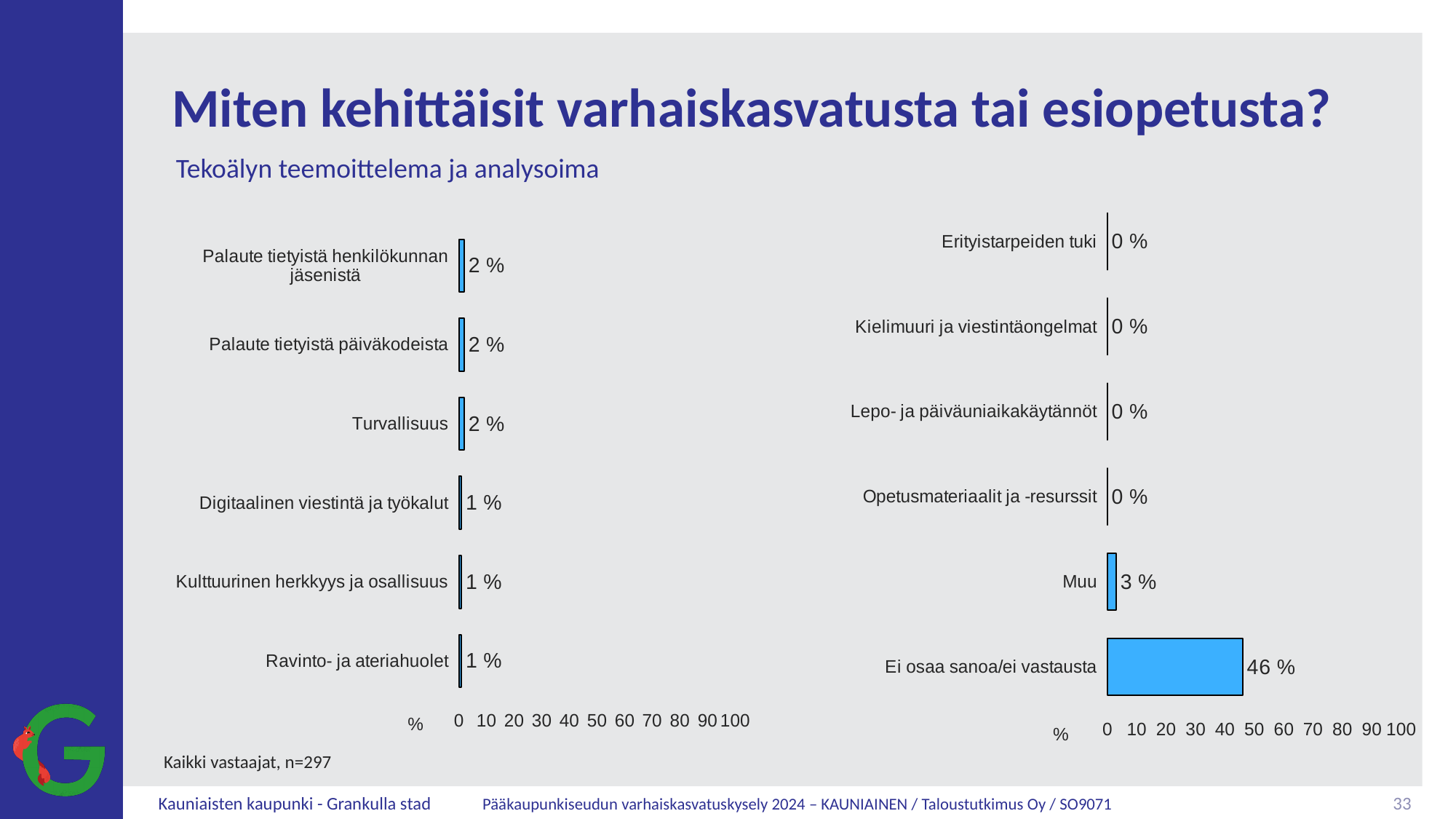
In the right chart, what is the difference between Ei osaa sanoa/ei vastausta and Muu? 43 % In the right chart, what is the value for Kielimuuri ja viestintäongelmat? 0 % In the left chart, what is the difference between Palaute tietyistä päiväkodeista and Digitaalinen viestintä ja työkalut? 1 % In the right chart, which category has the highest value? Ei osaa sanoa/ei vastausta In the right chart, is the value for Ei osaa sanoa/ei vastausta greater or less than 40? greater In the right chart, what is the value for Ei osaa sanoa/ei vastausta? 46 % In the right chart, what is the value for Muu? 3 % How many categories does the left chart show? 6 In the left chart, which is larger: Turvallisuus or Kulttuurinen herkkyys ja osallisuus? Turvallisuus In the left chart, what is the value for Ravinto- ja ateriahuolet? 1 % What kind of chart is the right chart? bar chart In the left chart, what is the value for Turvallisuus? 2 %